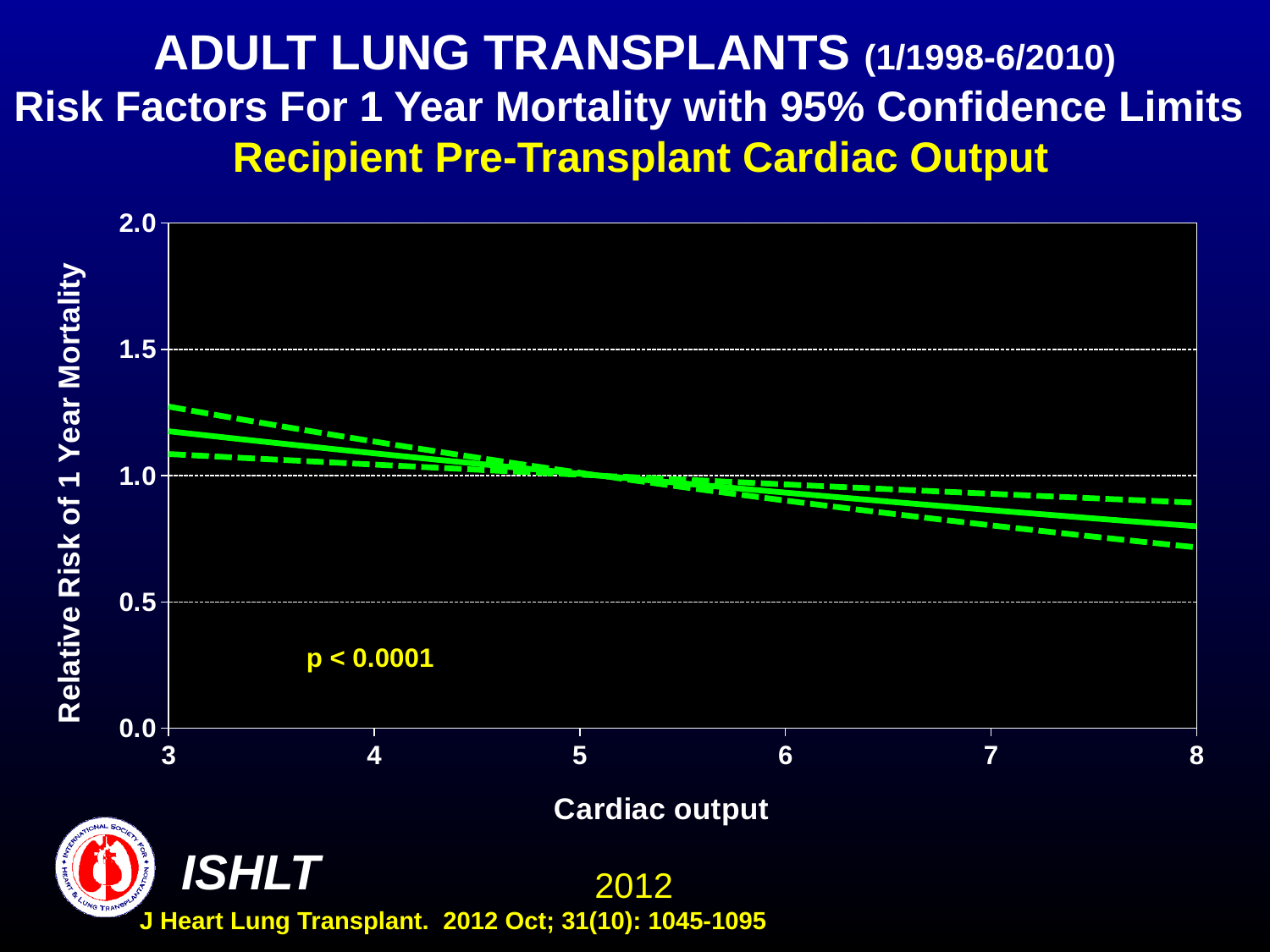
Is the relative risk of 1 year mortality at a cardiac output of 8 greater or less than 1.0? less Is the relative risk of 1 year mortality at a cardiac output of 3 greater or less than 1.5? less Is the relative risk of 1 year mortality at a cardiac output of 8 greater or less than 0.5? greater What kind of chart is shown on the slide? line chart Does the relative risk of 1 year mortality rise or fall as cardiac output increases from 3 to 8? fall Which has the higher relative risk of 1 year mortality: a cardiac output of 4 or a cardiac output of 7? 4 What is the highest value shown on the y axis? 2.0 What is the label of the x axis? Cardiac output How many lines are plotted on the chart (the estimate plus its confidence limits)? 3 What p-value is printed on the chart? p < 0.0001